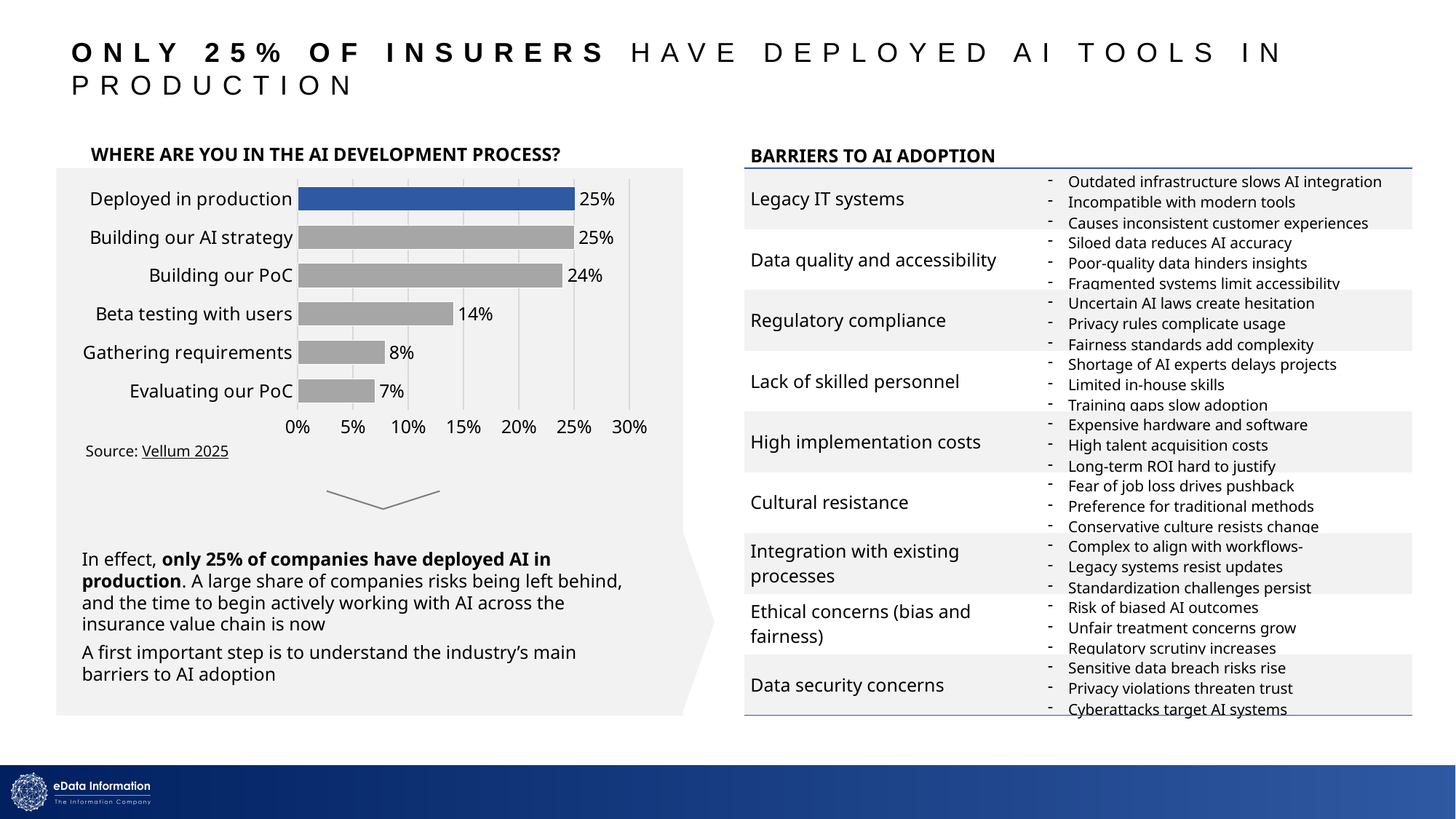
Which is larger, 'Beta testing with users' or 'Gathering requirements'? Beta testing with users Which stage has the lowest percentage? Evaluating our PoC What percentage of respondents are 'Beta testing with users'? 14% How many stages are shown in the chart? 6 What is the source cited below the chart? Vellum 2025 What percentage of respondents are at the 'Deployed in production' stage? 25% What is the value for 'Building our PoC'? 24% Is the value for 'Beta testing with users' greater or less than 10%? greater What is the value for 'Gathering requirements'? 8% What kind of chart is shown on the slide? Bar chart What is the difference between 'Deployed in production' and 'Evaluating our PoC'? 18% What is the difference between 'Building our PoC' and 'Beta testing with users'? 10%